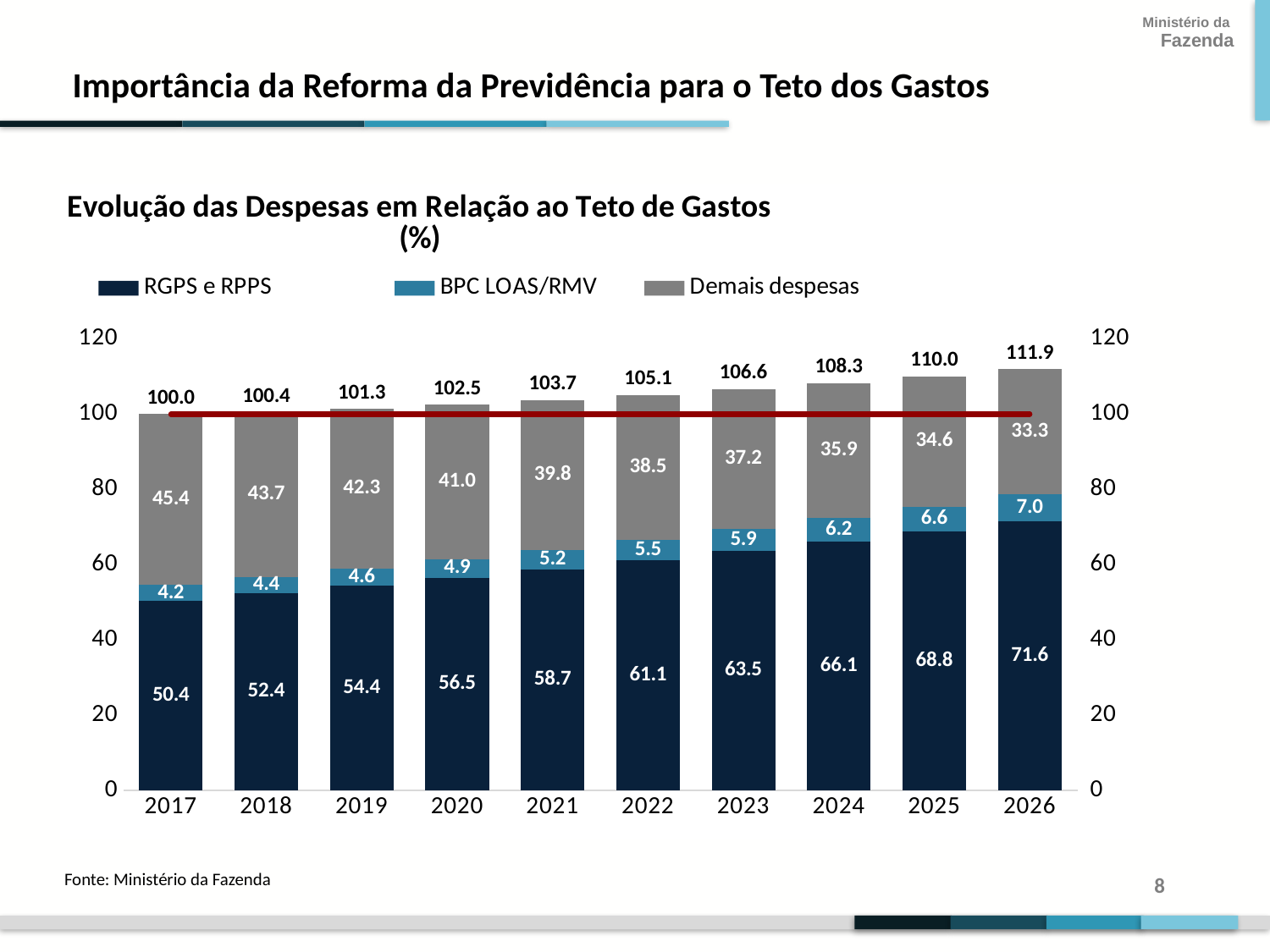
How many series does the legend list? 3 In which year is the Demais despesas value lowest? 2026 What is the total labelled above the stacked bar for 2026? 111.9 In which year is the RGPS e RPPS value highest? 2026 What is the value of BPC LOAS/RMV for 2023? 5.9 In 2017, which is larger: RGPS e RPPS or Demais despesas? RGPS e RPPS What kind of chart is shown on the slide? Stacked bar chart What is the difference between the RGPS e RPPS value in 2026 and in 2017? 21.2 What is the value of RGPS e RPPS for 2020? 56.5 How many years are shown on the x axis? 10 Does the RGPS e RPPS value rise or fall from 2017 to 2026? Rise What is the value of Demais despesas for 2017? 45.4